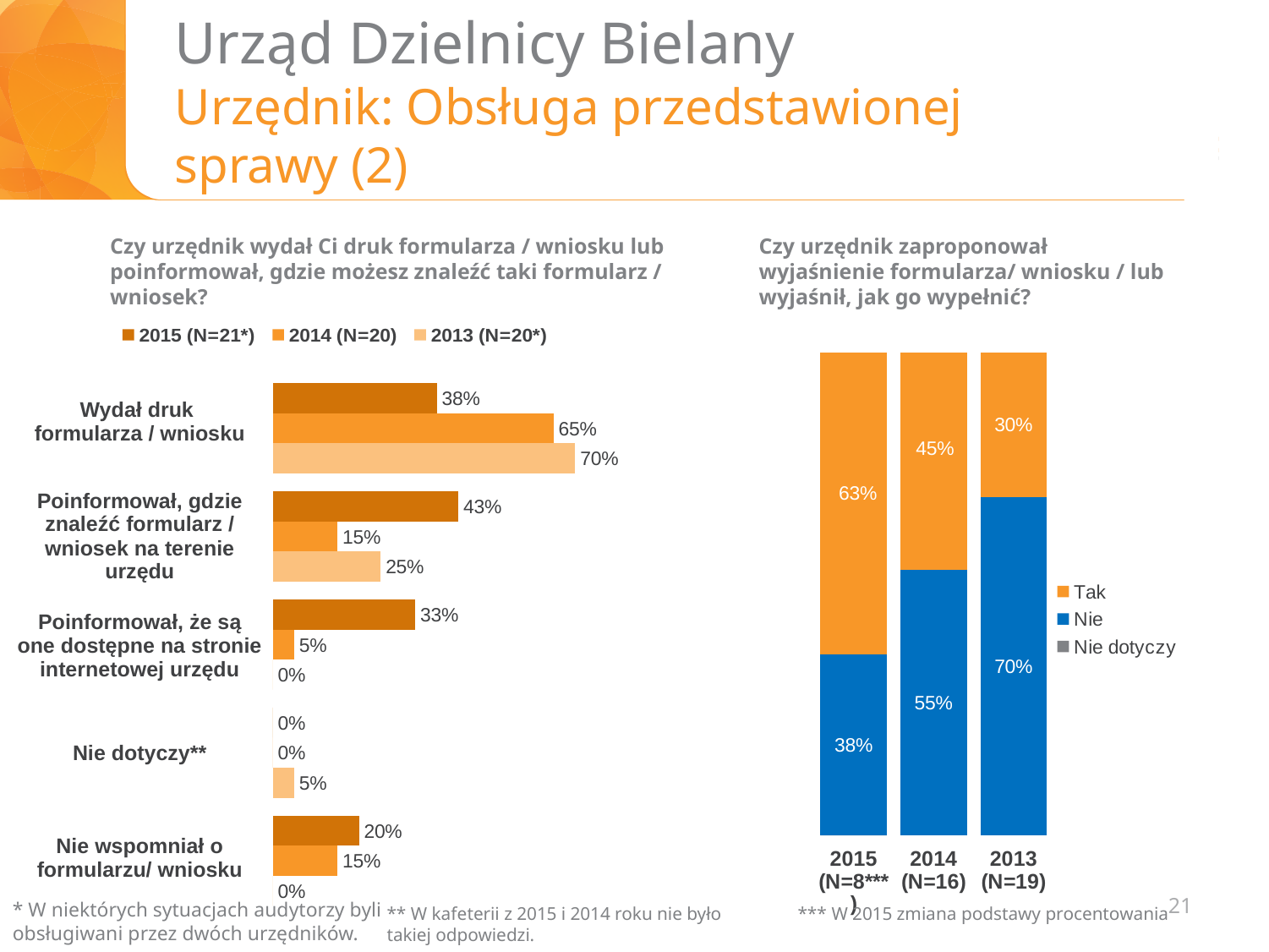
How many series does the legend of the left chart list? 3 In the left chart, which is larger for 'Poinformował, że są one dostępne na stronie internetowej urzędu': the 2015 value or the 2014 value? 2015 In the left chart, what is the difference between the 2013 and 2015 values for 'Wydał druk formularza / wniosku'? 32% In the left chart, which year has the highest value for 'Wydał druk formularza / wniosku'? 2013 (N=20*) In the right chart, what is the 'Nie' value for 2013? 70% In the right chart (Czy urzędnik zaproponował wyjaśnienie formularza...), what is the 'Tak' value for 2014? 45% How many categories are shown in the left chart? 5 In the left chart, what is the 2014 value for 'Nie wspomniał o formularzu/ wniosku'? 15% What type of chart is the left chart? Bar chart In the left chart (Czy urzędnik wydał Ci druk formularza...), what is the 2015 value for 'Wydał druk formularza / wniosku'? 38% In the left chart, what is the 2013 value for 'Poinformował, gdzie znaleźć formularz / wniosek na terenie urzędu'? 25% In the right chart, how does the 'Tak' share change from 2015 to 2013? It falls